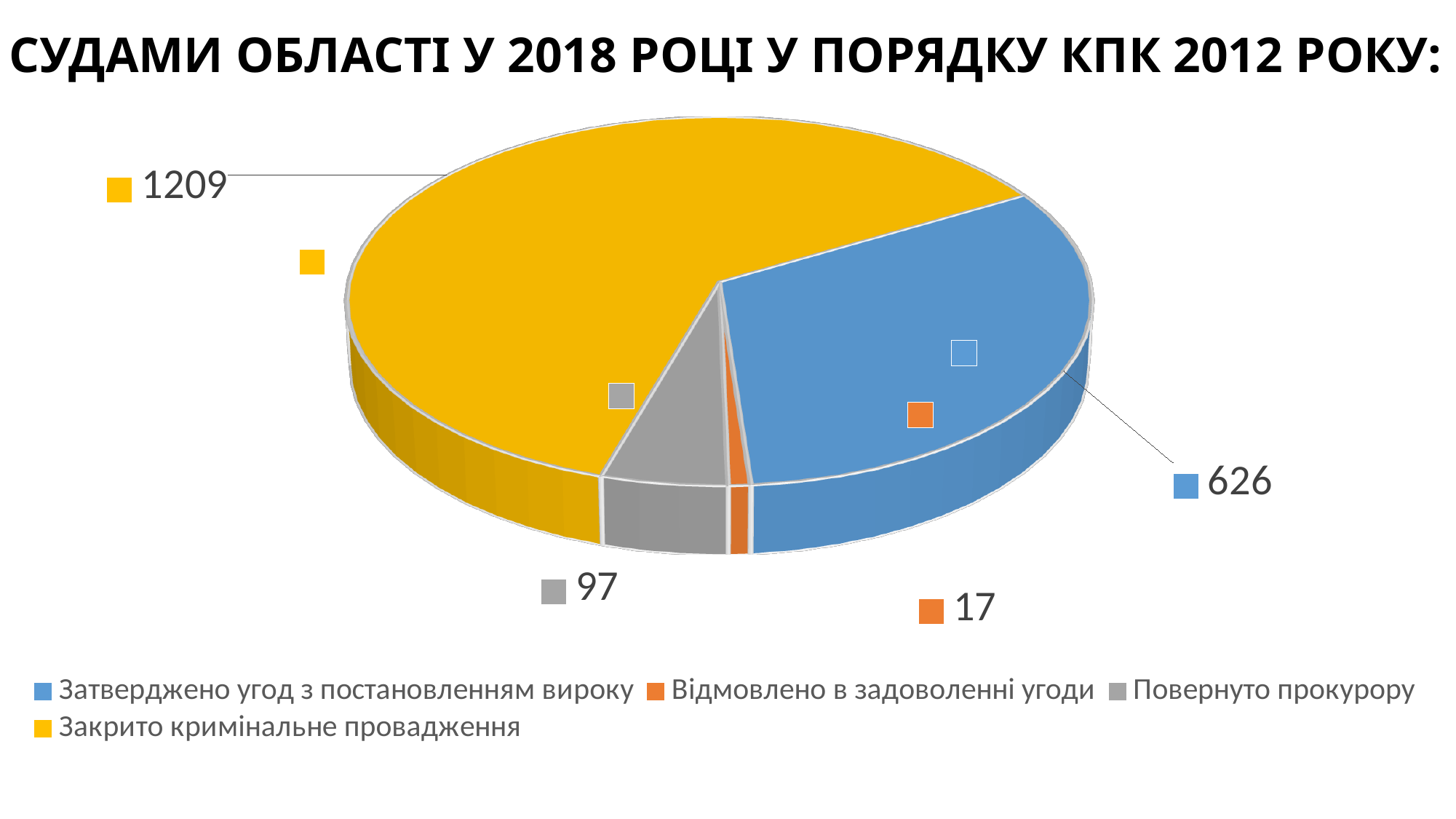
What type of chart is shown on the slide? Pie chart Which is larger: the value for "Повернуто прокурору" or the value for "Відмовлено в задоволенні угоди"? Повернуто прокурору What value is shown for "Затверджено угод з постановленням вироку"? 626 What value is shown for "Відмовлено в задоволенні угоди"? 17 What colour is the slice for "Повернуто прокурору"? Gray What is the total of all the values shown in the pie chart? 1949 What value is shown for "Закрито кримінальне провадження"? 1209 How many slices does the pie chart have? 4 Which category has the smallest slice of the pie? Відмовлено в задоволенні угоди Which category has the largest slice of the pie? Закрито кримінальне провадження What is the difference between the values for "Закрито кримінальне провадження" and "Затверджено угод з постановленням вироку"? 583 What value is shown for "Повернуто прокурору"? 97